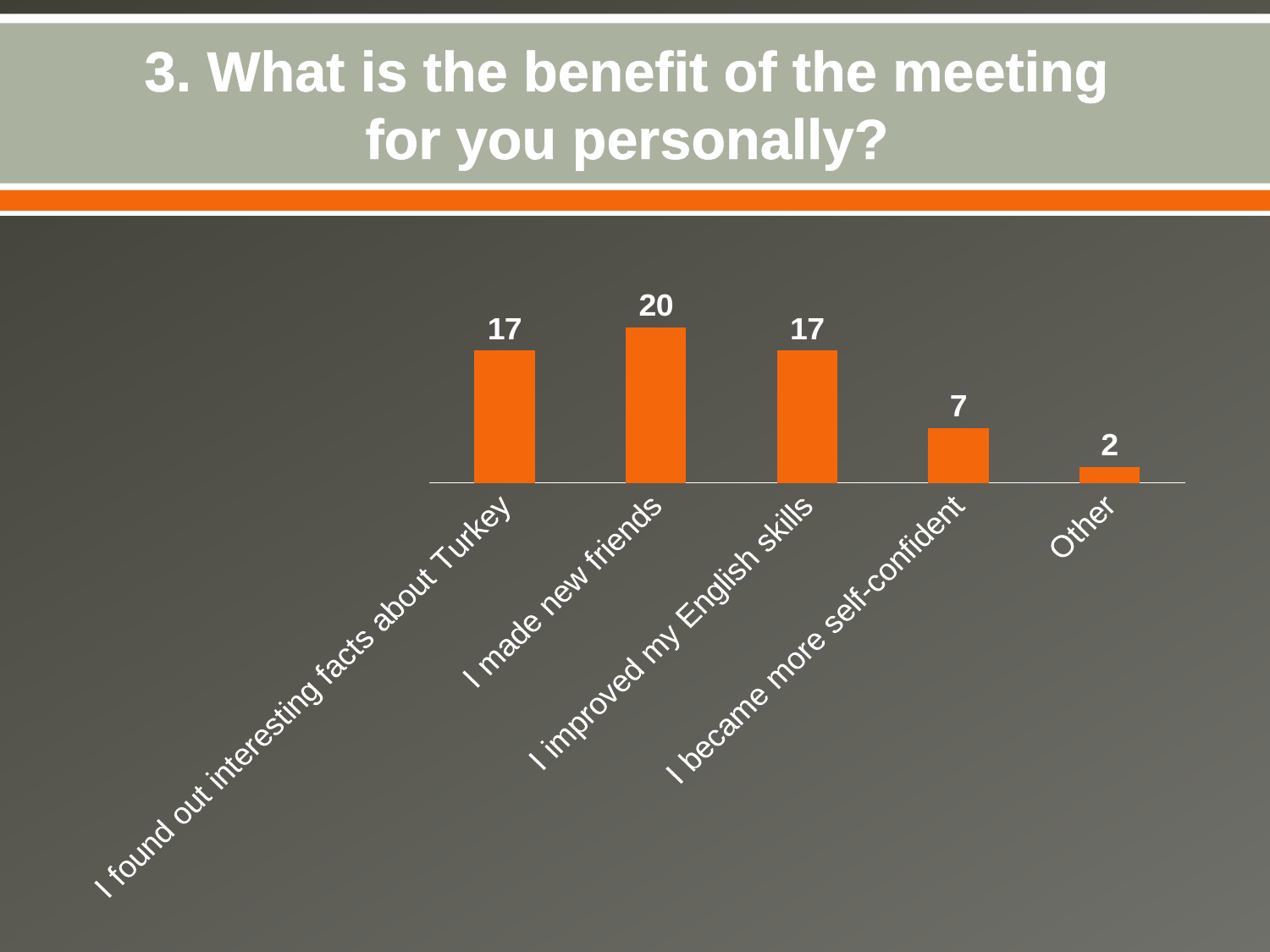
What kind of chart is shown on the slide? Bar chart What value is shown for "I made new friends"? 20 How many categories are shown in the chart? 5 What is the difference between the values for "I made new friends" and "I became more self-confident"? 13 Which is larger: the value for "I made new friends" or the value for "I improved my English skills"? I made new friends What colour are the bars in the chart? Orange Which category has the highest value? I made new friends What value is shown for "Other"? 2 Which category has the lowest value? Other What value is shown for "I improved my English skills"? 17 What value is shown for "I became more self-confident"? 7 What is the difference between the values for "I found out interesting facts about Turkey" and "Other"? 15